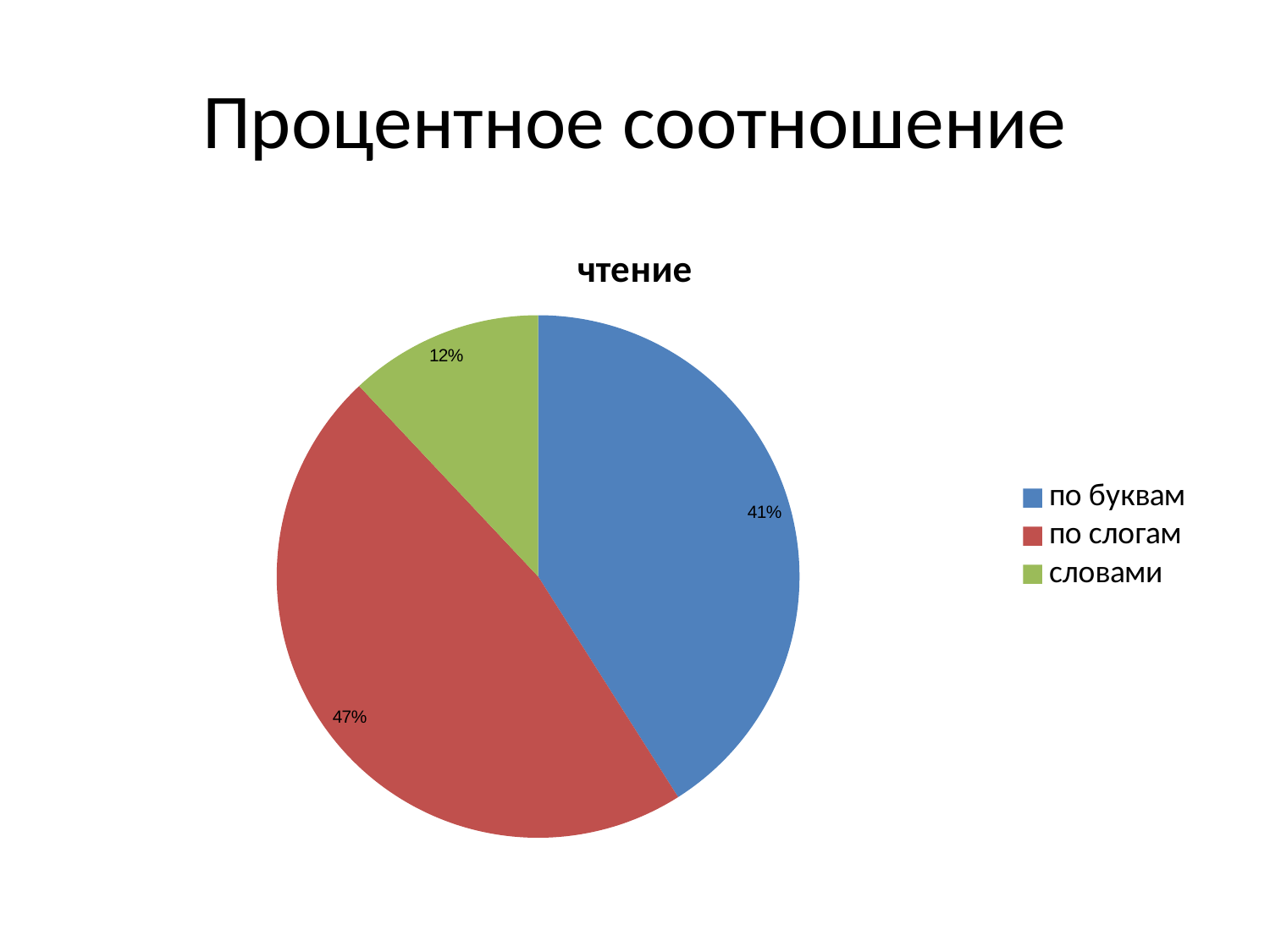
What colour is the slice for "словами"? green What percentage is shown for "по буквам"? 41% Which category has the smallest share of the pie? словами What percentage is shown for "словами"? 12% What is the difference between the shares of "по буквам" and "словами"? 29% What is the difference between the shares of "по слогам" and "по буквам"? 6% What percentage is shown for "по слогам"? 47% How many slices does the pie chart have? 3 What is the title of the chart? чтение Which is larger, the share for "по буквам" or the share for "словами"? по буквам Which category has the largest share of the pie? по слогам What kind of chart is shown on the slide? pie chart